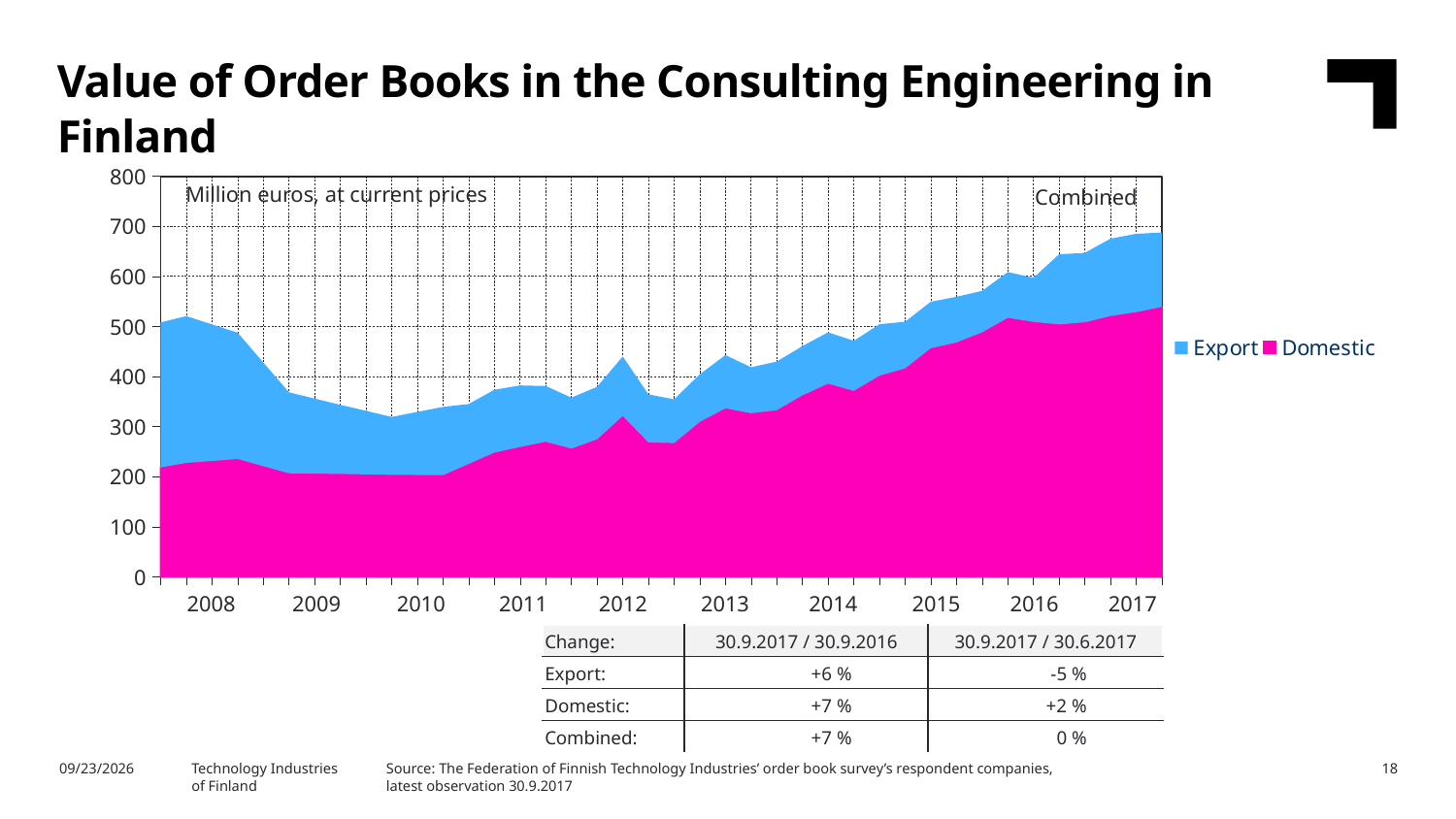
Is the combined value in 2010 greater or less than 400? less In 2017, which is larger, the Export portion or the Domestic portion? Domestic How many years are labelled on the x axis? 10 Is the Domestic value at the end of 2017 greater or less than 500? greater What are the two series named in the legend? Export and Domestic Is the combined value of order books at the end of 2017 greater or less than 600? greater What type of chart is shown on the slide? Stacked area chart Does the Domestic value rise or fall from 2012 to 2017? Rise How many series does the legend list? 2 What unit is stated in the label inside the chart area? Million euros, at current prices According to the table, what is the change in Export order books for 30.9.2017 / 30.9.2016? +6 %